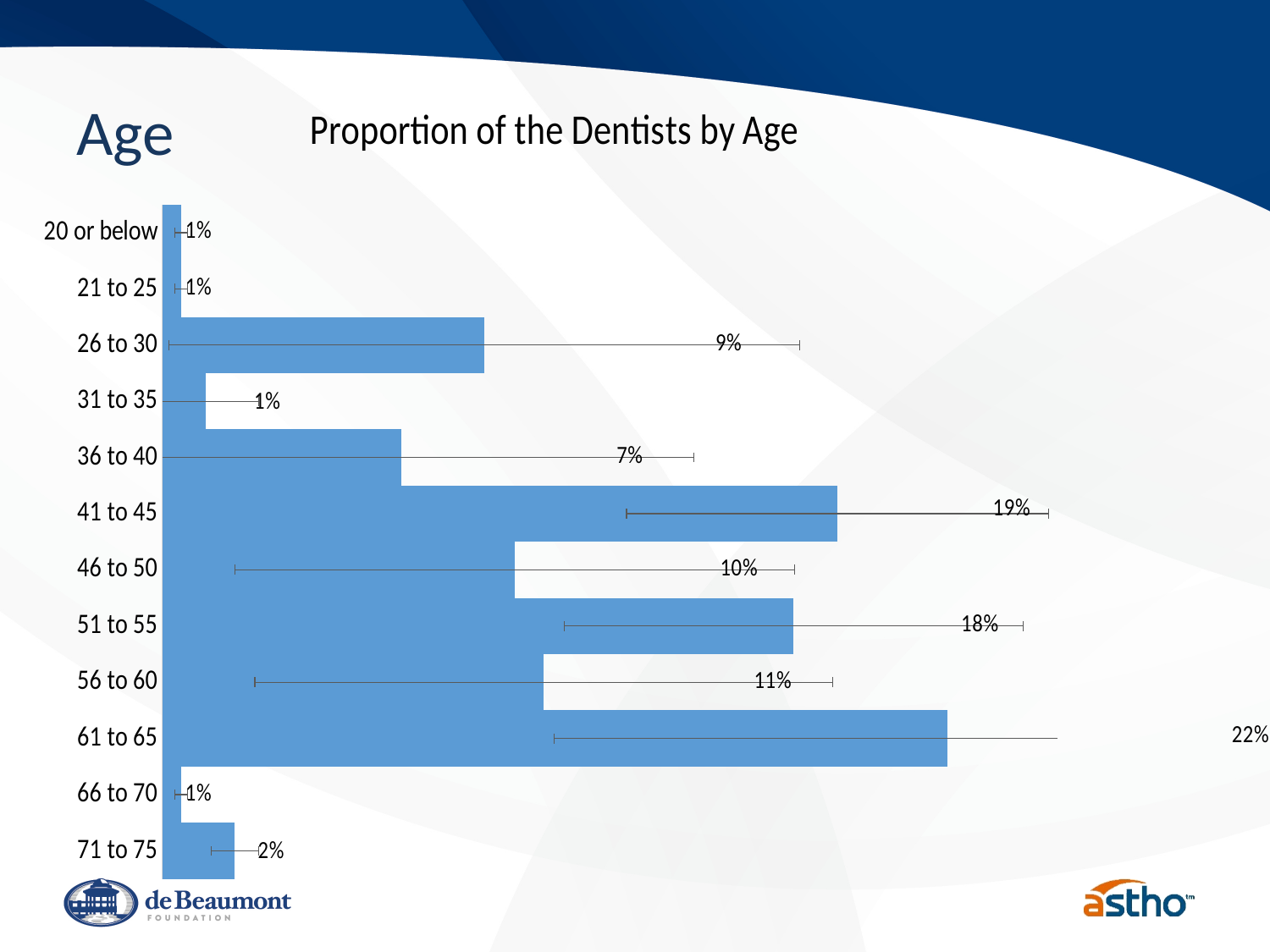
What is the value for the 61 to 65 age group? 22% What is the difference between the values for 51 to 55 and 46 to 50? 8% How many age groups are shown in the chart? 12 What is the title of the chart? Proportion of the Dentists by Age What is the value for the 71 to 75 age group? 2% What is the difference between the values for 61 to 65 and 41 to 45? 3% What proportion of dentists are aged 41 to 45? 19% What is the value shown for the 26 to 30 age group? 9% Which is larger, the value for 26 to 30 or the value for 36 to 40? 26 to 30 What is the value for the 56 to 60 age group? 11% What kind of chart is shown on the slide? Bar chart Which age group has the highest proportion of dentists? 61 to 65